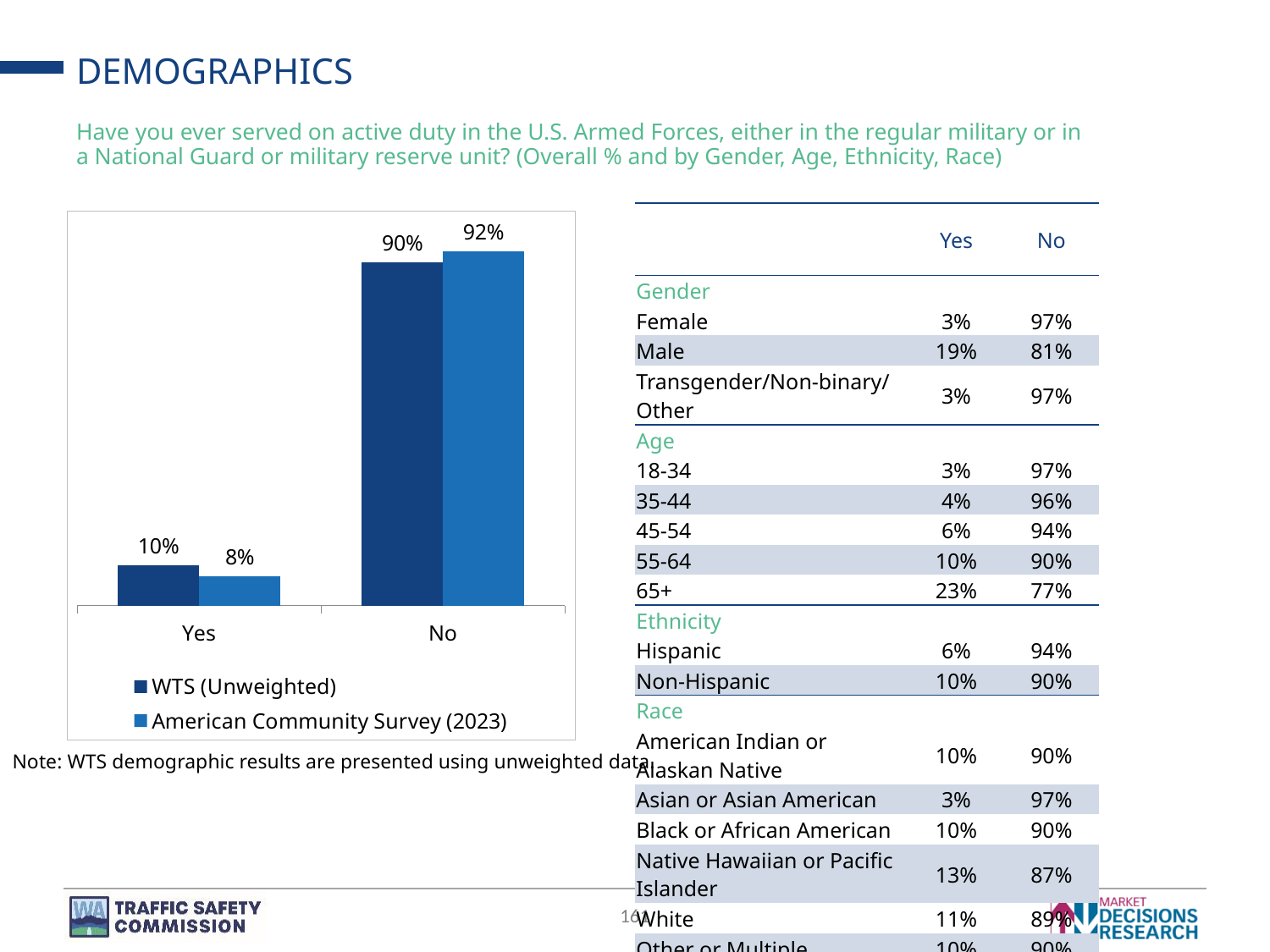
What kind of chart is shown on the slide? Bar chart Which category has the lowest American Community Survey (2023) value? Yes How many series does the chart's legend list? 2 How many categories are shown on the x axis of the chart? 2 For No, which series has the larger value, WTS (Unweighted) or American Community Survey (2023)? American Community Survey (2023) What is the WTS (Unweighted) value for No? 90% What is the difference between the WTS (Unweighted) and American Community Survey (2023) values for Yes? 2% Which category has the highest WTS (Unweighted) value? No What are the two series named in the chart's legend? WTS (Unweighted) and American Community Survey (2023) What is the American Community Survey (2023) value for No? 92% What is the American Community Survey (2023) value for Yes? 8% What is the WTS (Unweighted) value for Yes? 10%